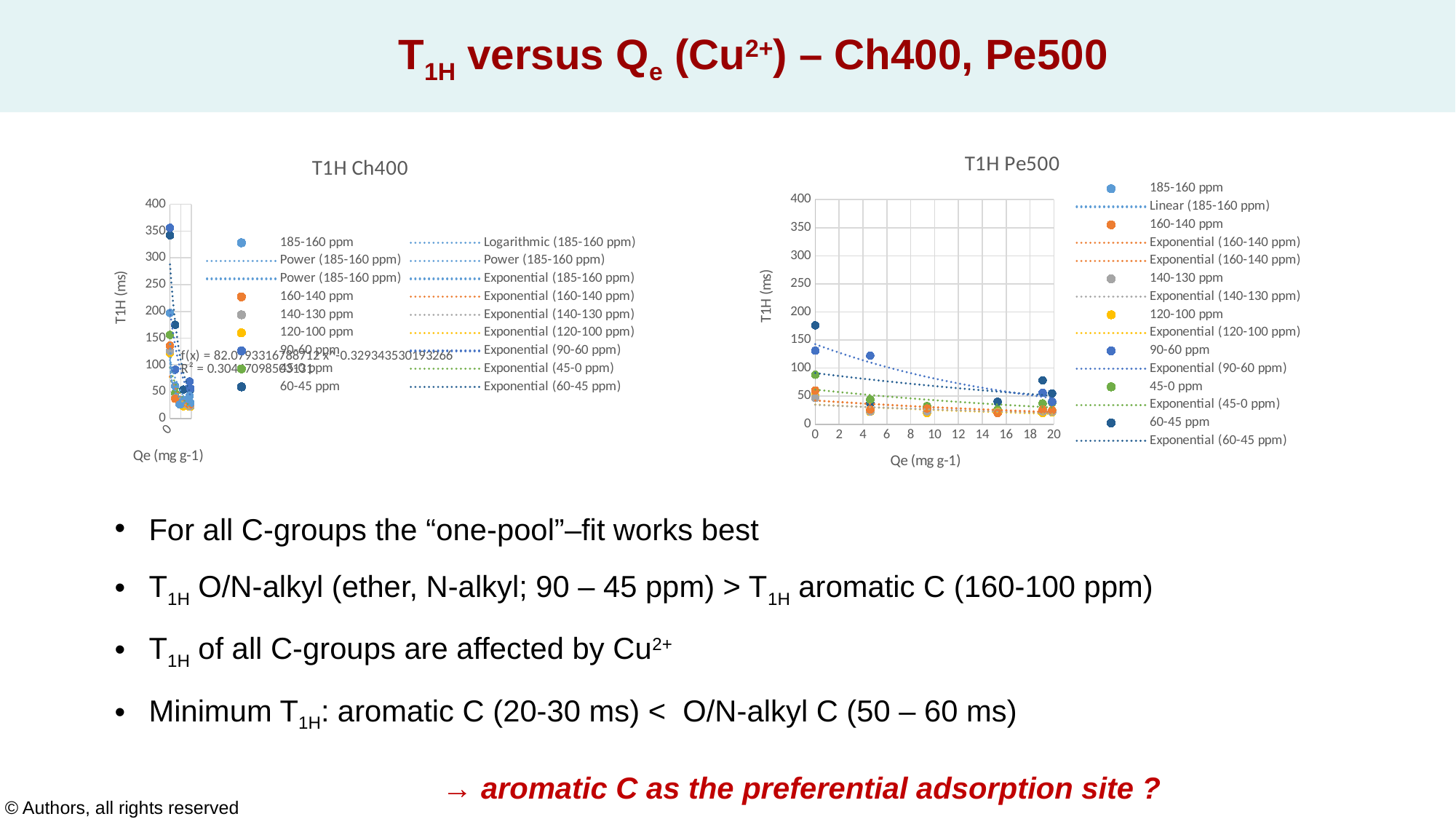
In the T1H Pe500 chart, how many ppm ranges (data series, excluding trendlines) are listed in the legend? 7 In the T1H Pe500 chart, at Qe = 0, which series has the larger value: 60-45 ppm or 160-140 ppm? 60-45 ppm What kind of chart is the T1H Pe500 chart? scatter chart In the T1H Pe500 chart, what is the highest tick value shown on the x axis? 20 What is the title of the chart on the right side of the slide? T1H Pe500 In the T1H Pe500 chart, is the value for the 160-140 ppm series at Qe of about 15 greater or less than 50? less In the T1H Pe500 chart, is the value for the 60-45 ppm series at Qe = 0 greater or less than 150? greater In the T1H Pe500 chart, what is the label of the y axis? T1H (ms) In the T1H Ch400 chart, is the highest plotted point greater or less than 300? greater What is the title of the chart on the left side of the slide? T1H Ch400 In the T1H Pe500 chart, what is the highest value shown on the y axis? 400